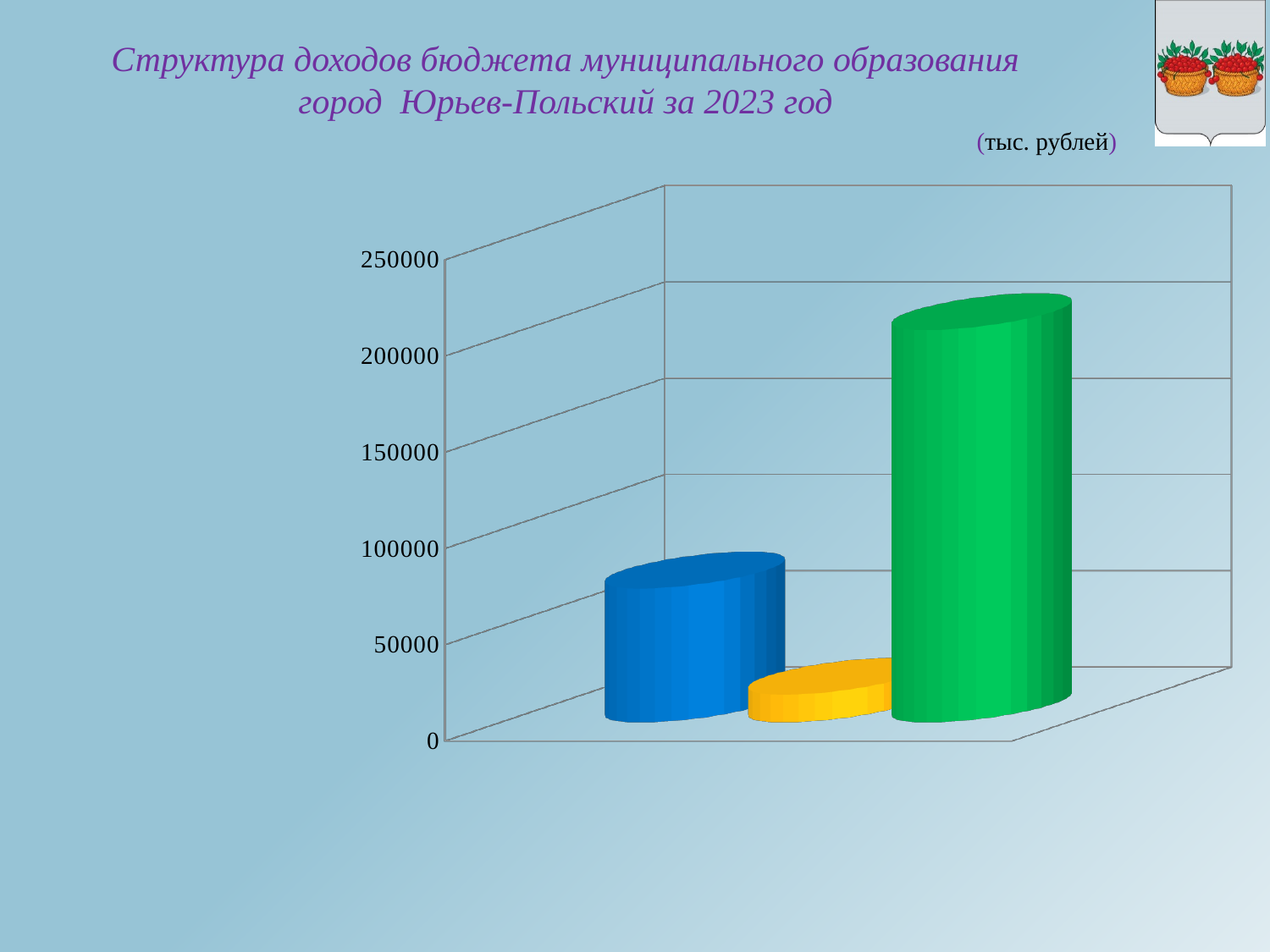
Is the value of the green bar greater or less than 150000? greater Is the value of the yellow bar greater or less than 50000? less Which bar is the tallest in the chart? the green bar How many bars are plotted in the chart? 3 Which is larger, the green bar or the blue bar? the green bar Which is larger, the blue bar or the yellow bar? the blue bar What is the highest value shown on the vertical axis of the chart? 250000 Is the value of the blue bar greater or less than 50000? greater Which bar is the shortest in the chart? the yellow bar In what units are the values on the slide expressed? тыс. рублей What kind of chart is shown on the slide? bar chart